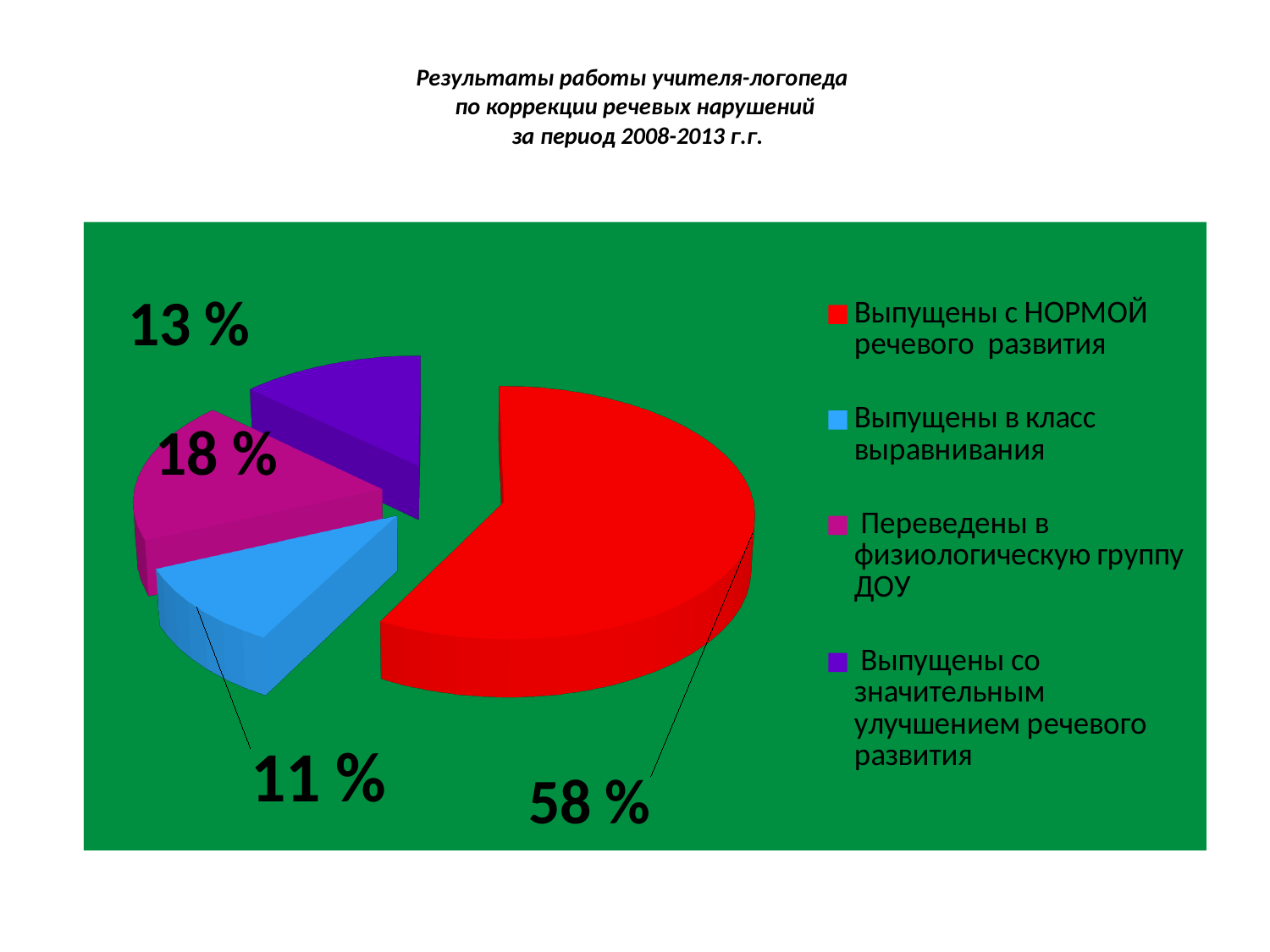
How many entries does the legend list? 4 What share of the pie is labelled for "Выпущены в класс выравнивания"? 11 % What is the difference in percentage points between the "Выпущены с НОРМОЙ речевого развития" slice and the "Переведены в физиологическую группу ДОУ" slice? 40 What share of the pie is labelled for "Выпущены со значительным улучшением речевого развития"? 13 % How many slices does the pie chart have? 4 Which is larger: the slice for "Выпущены со значительным улучшением речевого развития" or the slice for "Выпущены в класс выравнивания"? Выпущены со значительным улучшением речевого развития What share of the pie is labelled for "Выпущены с НОРМОЙ речевого развития"? 58 % What colour is the slice for "Выпущены в класс выравнивания"? blue What share of the pie is labelled for "Переведены в физиологическую группу ДОУ"? 18 % What kind of chart is shown on the slide? pie chart Which category has the largest slice of the pie? Выпущены с НОРМОЙ речевого развития Which category has the smallest slice of the pie? Выпущены в класс выравнивания